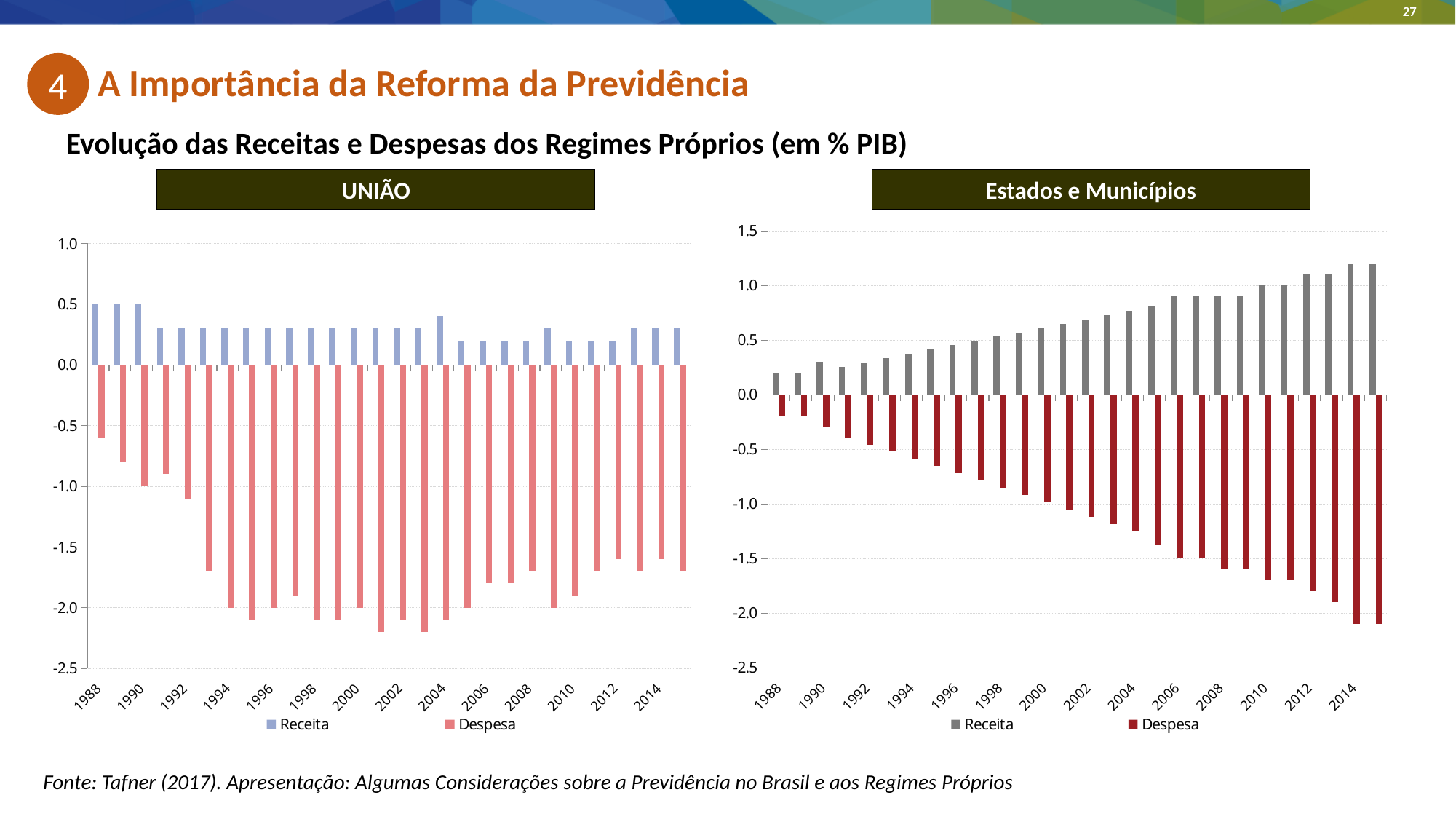
In the UNIÃO chart, which year has the larger Receita value, 1988 or 2015? 1988 In the Estados e Municípios chart, does the Receita series rise or fall from 1988 to 2015? rise In the Estados e Municípios chart, which year has the larger Receita value, 2000 or 2010? 2010 How many series does the legend of the Estados e Municípios chart list? 2 In the UNIÃO chart, is the Despesa value for 1988 greater or less than -1.0? greater What is the title of the chart on the right side of the slide? Estados e Municípios In the Estados e Municípios chart, is the Receita value for 2015 greater or less than 1.0? greater In the Estados e Municípios chart, is the Receita value for 1988 greater or less than 0.5? less What kind of chart is the UNIÃO chart? bar chart What are the two series named in the legend of the UNIÃO chart? Receita and Despesa